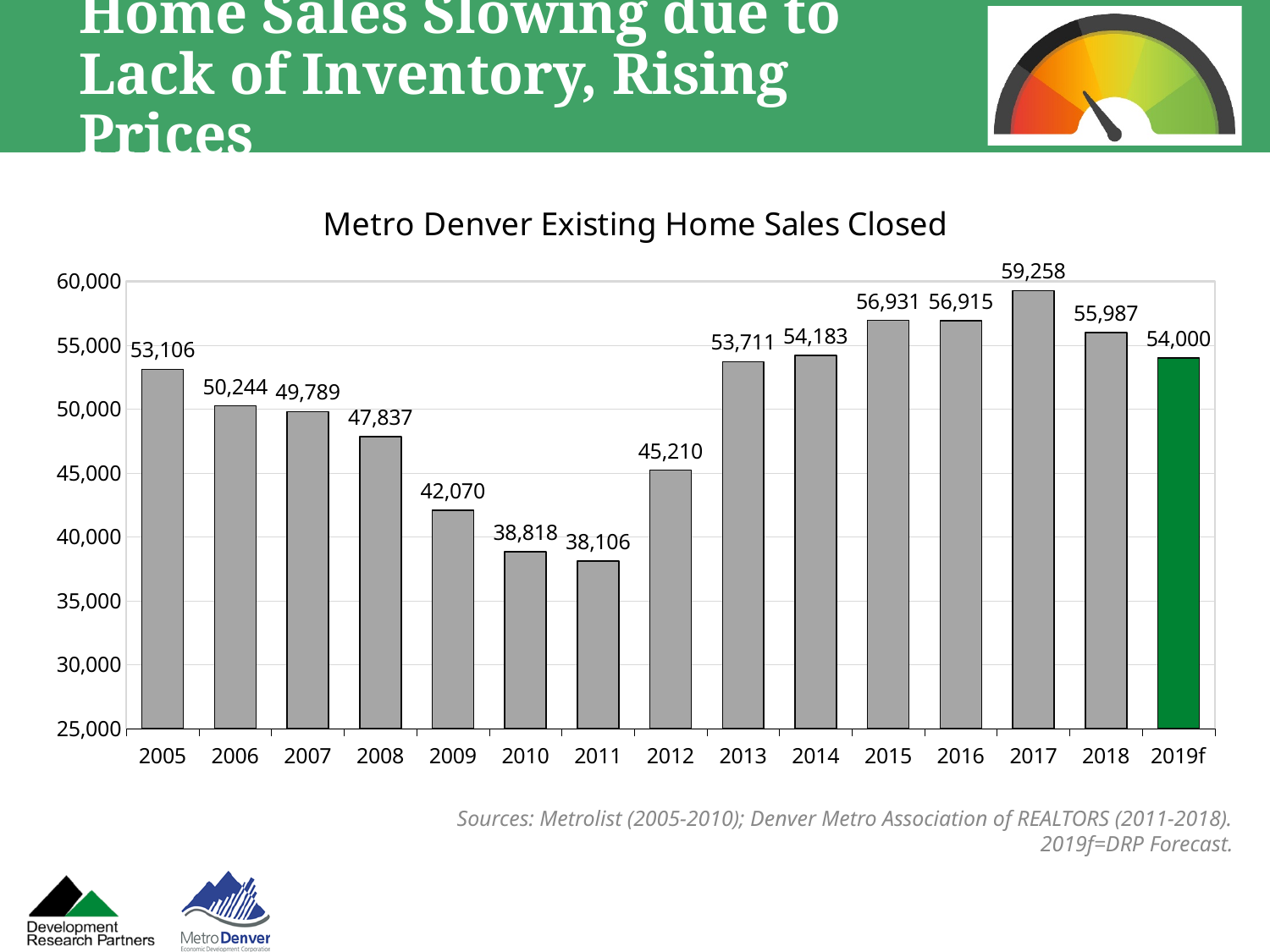
Which year has the highest value? 2017 What is the value for 2011? 38,106 What kind of chart is this? bar chart What is the title of the chart? Metro Denver Existing Home Sales Closed Which is larger, the value for 2015 or the value for 2016? 2015 Which year has the lowest value? 2011 What is the forecast value for 2019f? 54,000 How many years are shown on the x axis? 15 What is the value for 2017? 59,258 What is the difference between the 2017 value and the 2018 value? 3,271 Do the values rise or fall from 2005 to 2011? fall Is the value for 2012 greater or less than 45,000? greater